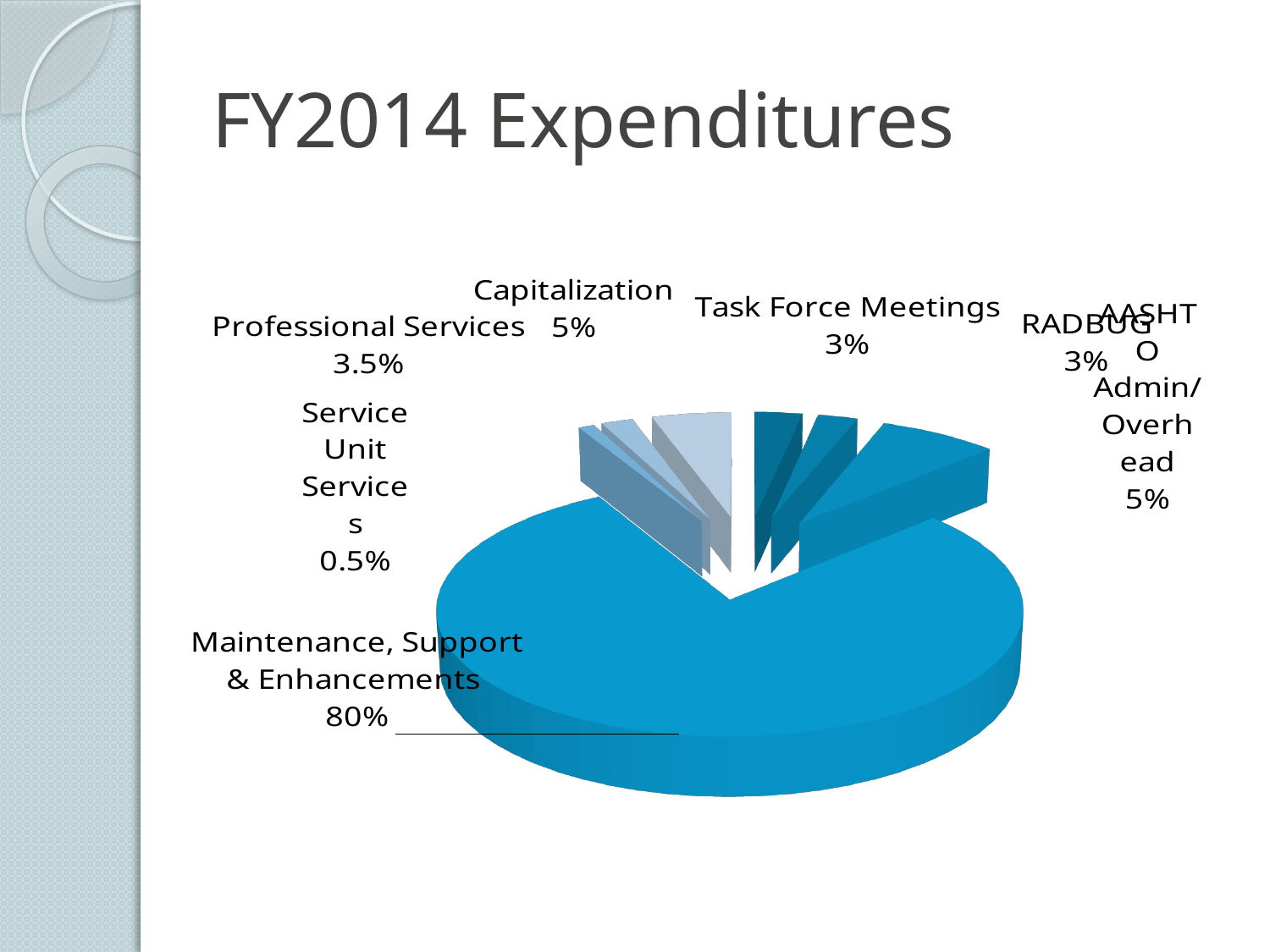
What percentage is shown for Service Unit Services? 0.5% How many percentage points larger is the Maintenance, Support & Enhancements share than the Capitalization share? 75 percentage points What is the title of the slide containing the chart? FY2014 Expenditures What percentage of FY2014 expenditures is labelled for Capitalization? 5% How many categories are shown in the pie chart? 7 What percentage is shown for Task Force Meetings? 3% What kind of chart is shown on the slide? Pie chart Which is larger, the share for Professional Services or the share for Task Force Meetings? Professional Services What share of FY2014 expenditures went to Maintenance, Support & Enhancements? 80% What percentage is shown for Professional Services? 3.5% Which category accounts for the largest share of FY2014 expenditures? Maintenance, Support & Enhancements Which category accounts for the smallest share of FY2014 expenditures? Service Unit Services